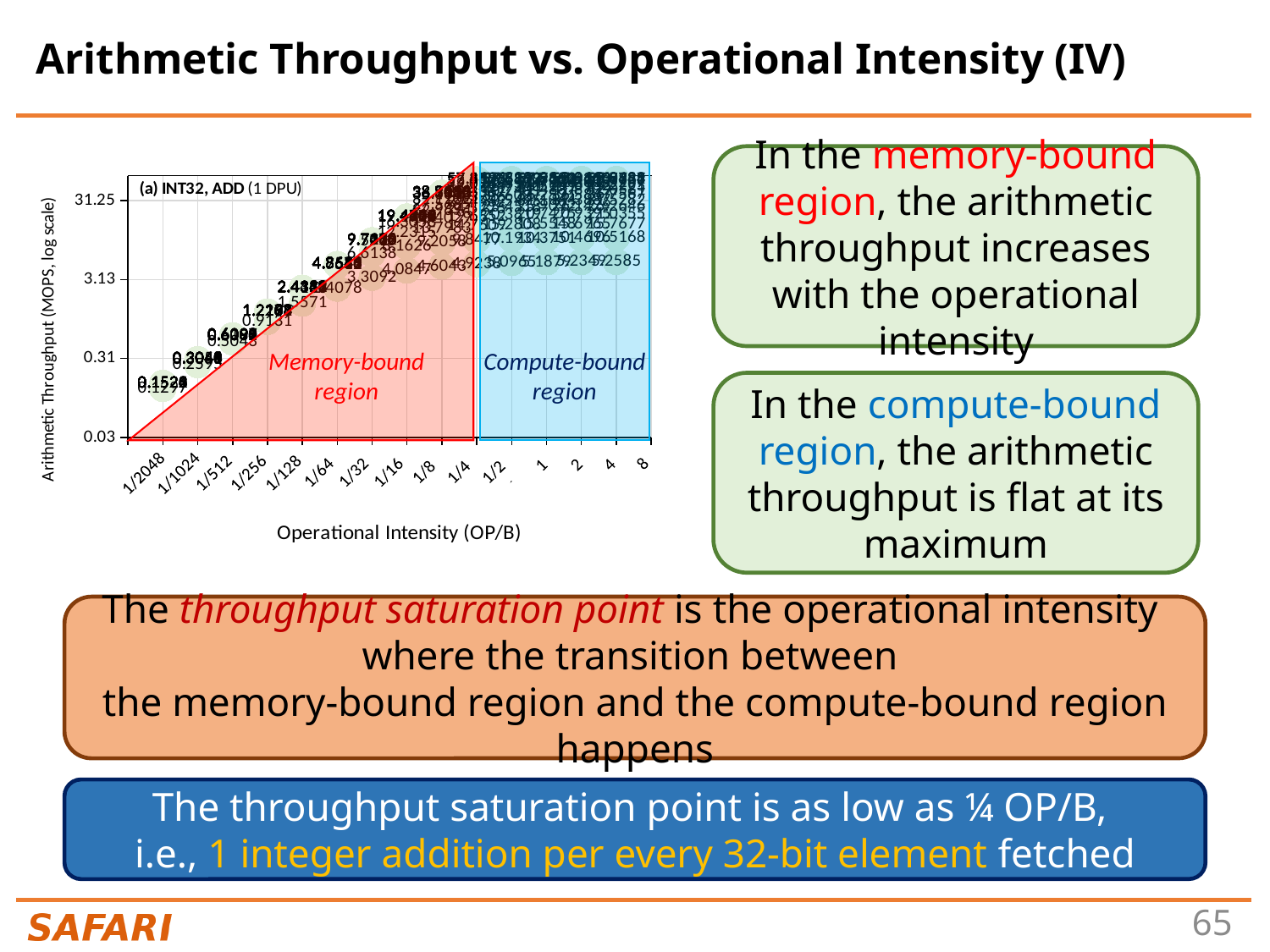
In the memory-bound region of the chart, does the arithmetic throughput rise or fall as operational intensity increases? rises What is the title of the x axis of the chart? Operational Intensity (OP/B) In the compute-bound region of the chart, does the arithmetic throughput rise, fall, or stay flat as operational intensity increases? stays flat At which operational intensity on the x axis is the arithmetic throughput lowest? 1/2048 Is the arithmetic throughput at operational intensity 1/2048 greater or less than 0.31 MOPS? less How many operational intensity values are marked on the x axis of the chart? 15 Is the arithmetic throughput at operational intensity 8 greater or less than 3.13 MOPS? greater Is the arithmetic throughput at operational intensity 1/256 greater or less than 3.13 MOPS? less What is the title of the y axis of the chart? Arithmetic Throughput (MOPS, log scale) Which two regions are shaded and labelled on the chart? Memory-bound region and Compute-bound region Which has the higher arithmetic throughput: operational intensity 1/1024 or operational intensity 1/16? 1/16